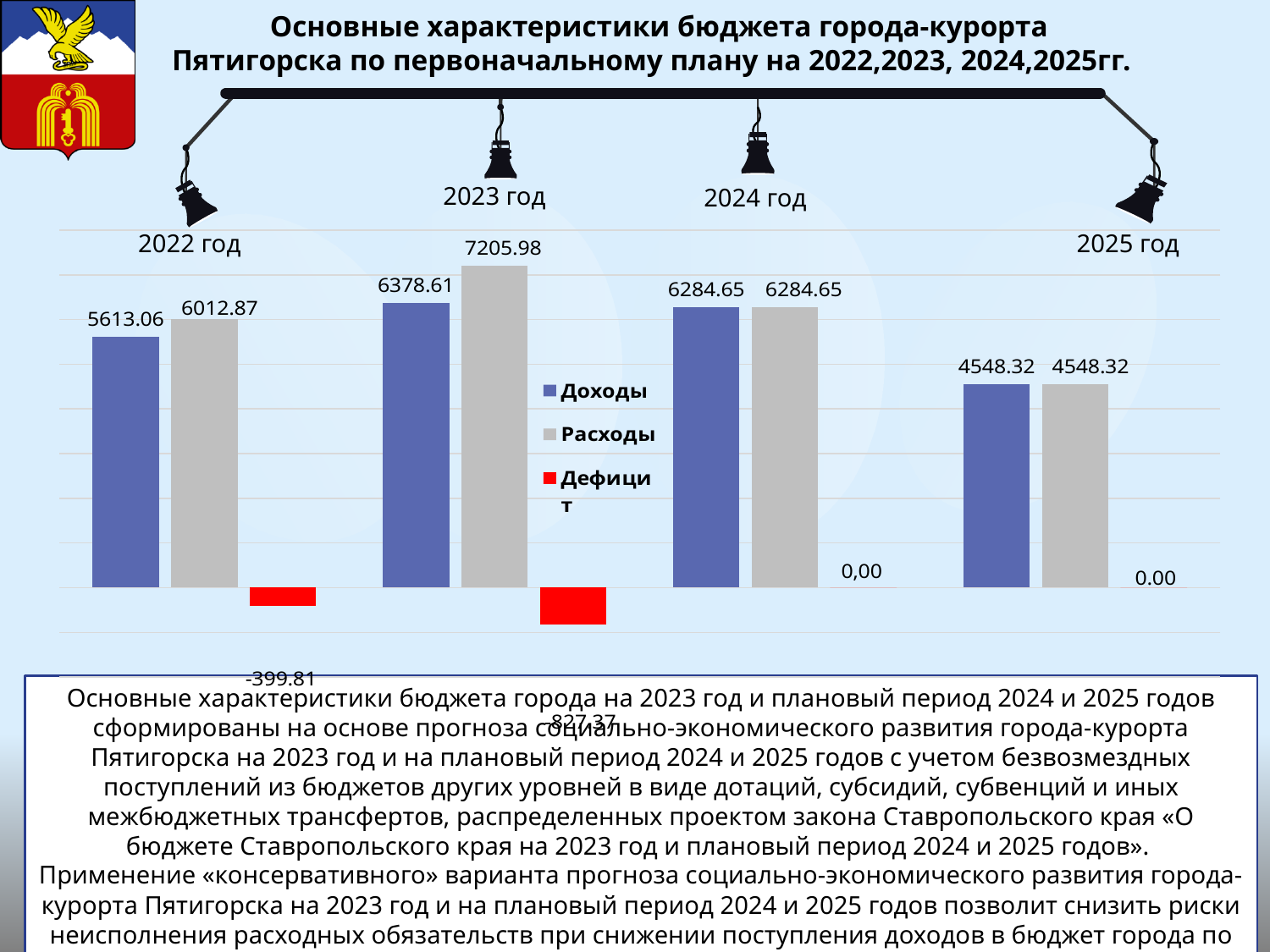
Which year has the lowest value of Доходы? 2025 год Which year has the highest value of Расходы? 2023 год Which is larger: Доходы for 2024 год or Доходы for 2025 год? Доходы for 2024 год What is the difference between Расходы and Доходы for 2022 год? 399.81 What colour represents Дефицит in the legend? Red How many series does the legend list? 3 What is the difference between Доходы for 2023 год and Доходы for 2022 год? 765.55 What kind of chart is shown on the slide? Bar chart What is the value of Дефицит for 2022 год? -399.81 What is the value of Расходы for 2025 год? 4548.32 What is the value of Расходы for 2022 год? 6012.87 What is the value of Доходы for 2023 год? 6378.61